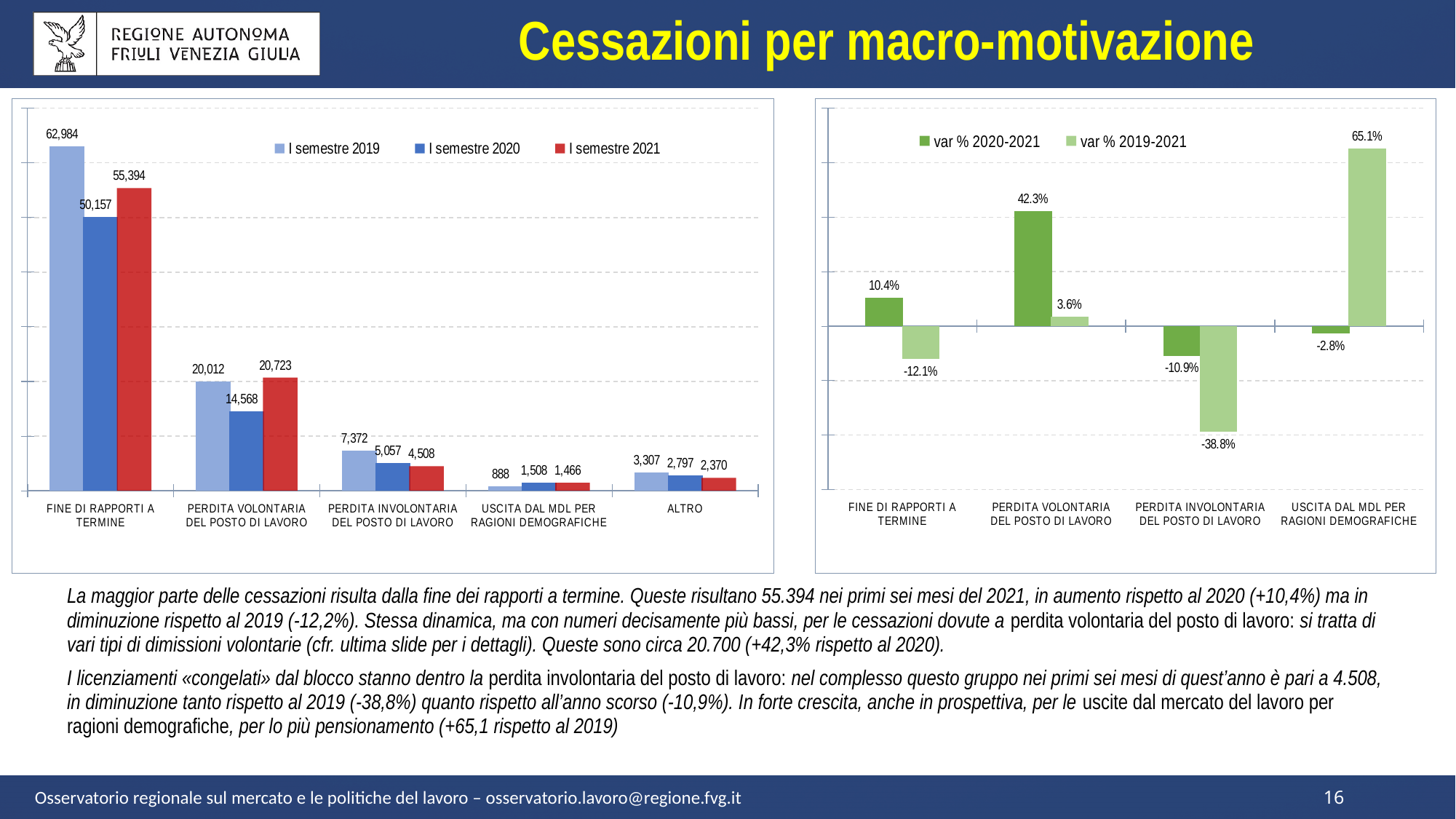
In the left chart, which category has the lowest value in I semestre 2019? USCITA DAL MDL PER RAGIONI DEMOGRAFICHE In the right chart, which category has the highest var % 2020-2021 value? PERDITA VOLONTARIA DEL POSTO DI LAVORO In the right chart, which category has the lowest var % 2019-2021 value? PERDITA INVOLONTARIA DEL POSTO DI LAVORO In the right chart, what is the var % 2019-2021 value for USCITA DAL MDL PER RAGIONI DEMOGRAFICHE? 65.1% What kind of chart is the right chart? bar chart In the left chart, what is the value for PERDITA VOLONTARIA DEL POSTO DI LAVORO in I semestre 2020? 14,568 In the left chart, which is larger for PERDITA INVOLONTARIA DEL POSTO DI LAVORO: I semestre 2020 or I semestre 2021? I semestre 2020 How many series does the legend of the left chart list? 3 In the right chart, what is the var % 2020-2021 value for FINE DI RAPPORTI A TERMINE? 10.4% In the left chart, what is the value for FINE DI RAPPORTI A TERMINE in I semestre 2021? 55,394 In the left chart, what is the difference between the I semestre 2019 and I semestre 2021 values for FINE DI RAPPORTI A TERMINE? 7,590 How many categories are shown on the x axis of the left chart? 5